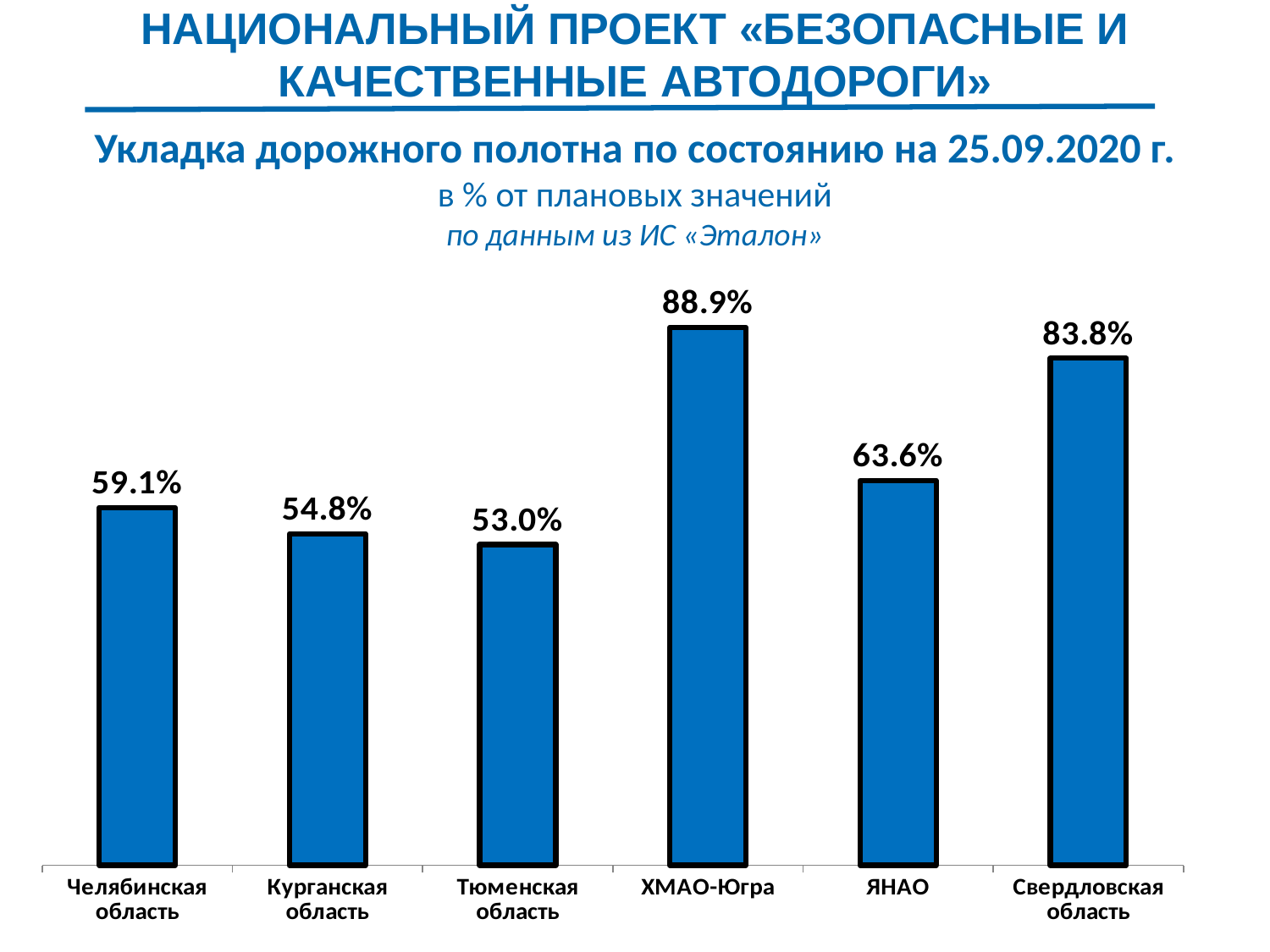
Which is larger, the value for ЯНАО or the value for Челябинская область? ЯНАО How many regions are shown on the chart? 6 Which region has the highest value? ХМАО-Югра What is the difference between the values for Челябинская область and Тюменская область? 6.1% What is the difference between the values for ХМАО-Югра and Свердловская область? 5.1% What is the value for Свердловская область? 83.8% What is the value for ЯНАО? 63.6% Which region has the lowest value? Тюменская область What is the value for Курганская область? 54.8% What kind of chart is shown on the slide? Bar chart According to the subtitle, as of what date is the road surface laying data shown? 25.09.2020 What is the value for ХМАО-Югра? 88.9%